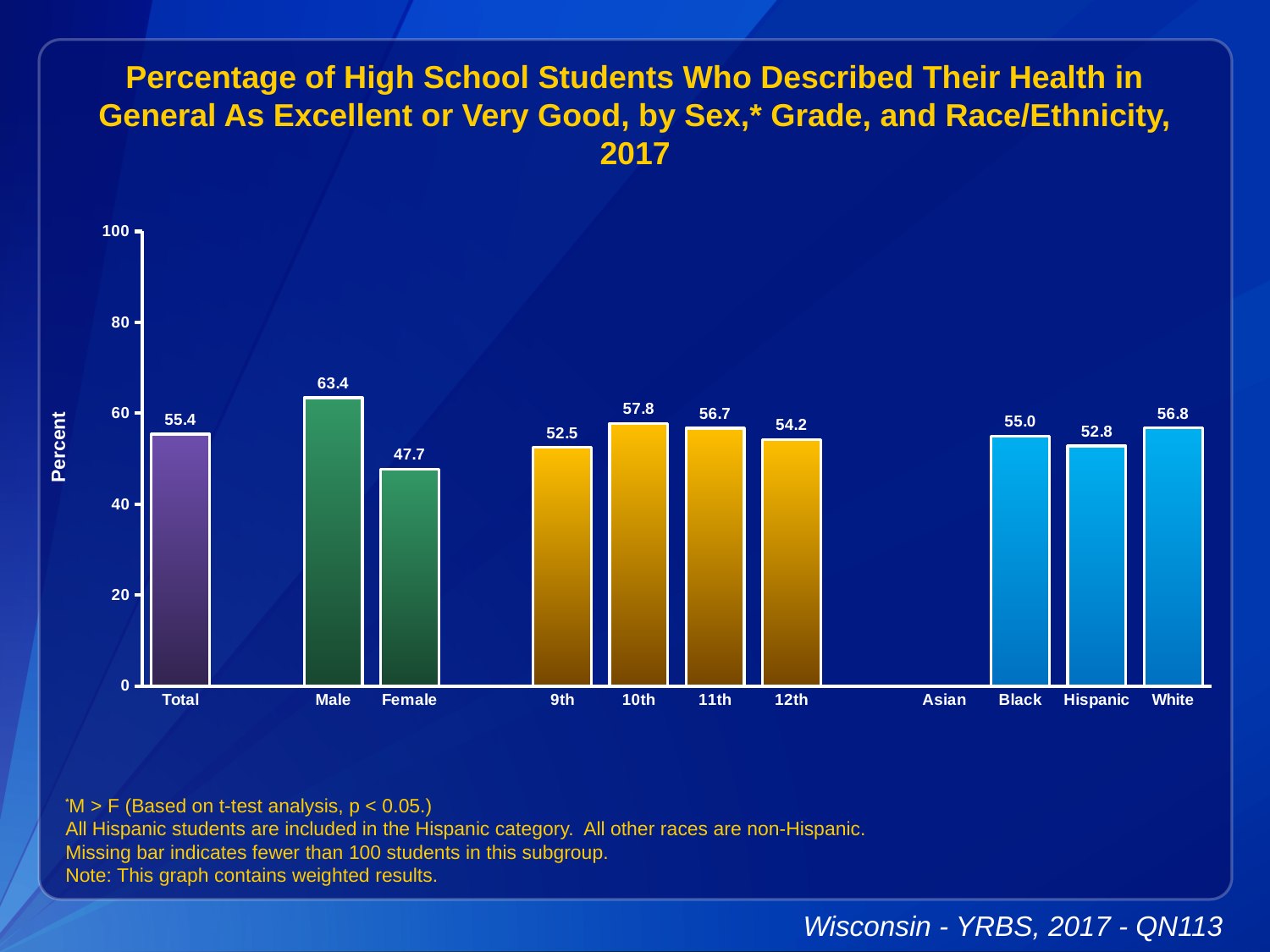
What is the value for Female? 47.7 Which category has the highest value? Male How many categories have a bar plotted? 10 Which category has no bar shown? Asian What kind of chart is this? bar chart Which is larger, the value for 9th grade or the value for 12th grade? 12th What is the value for 10th grade? 57.8 Which category has the lowest value? Female What is the value for Hispanic? 52.8 Is the value for White greater or less than 40? greater What is the value for Total? 55.4 What is the difference between the Male and Female values? 15.7